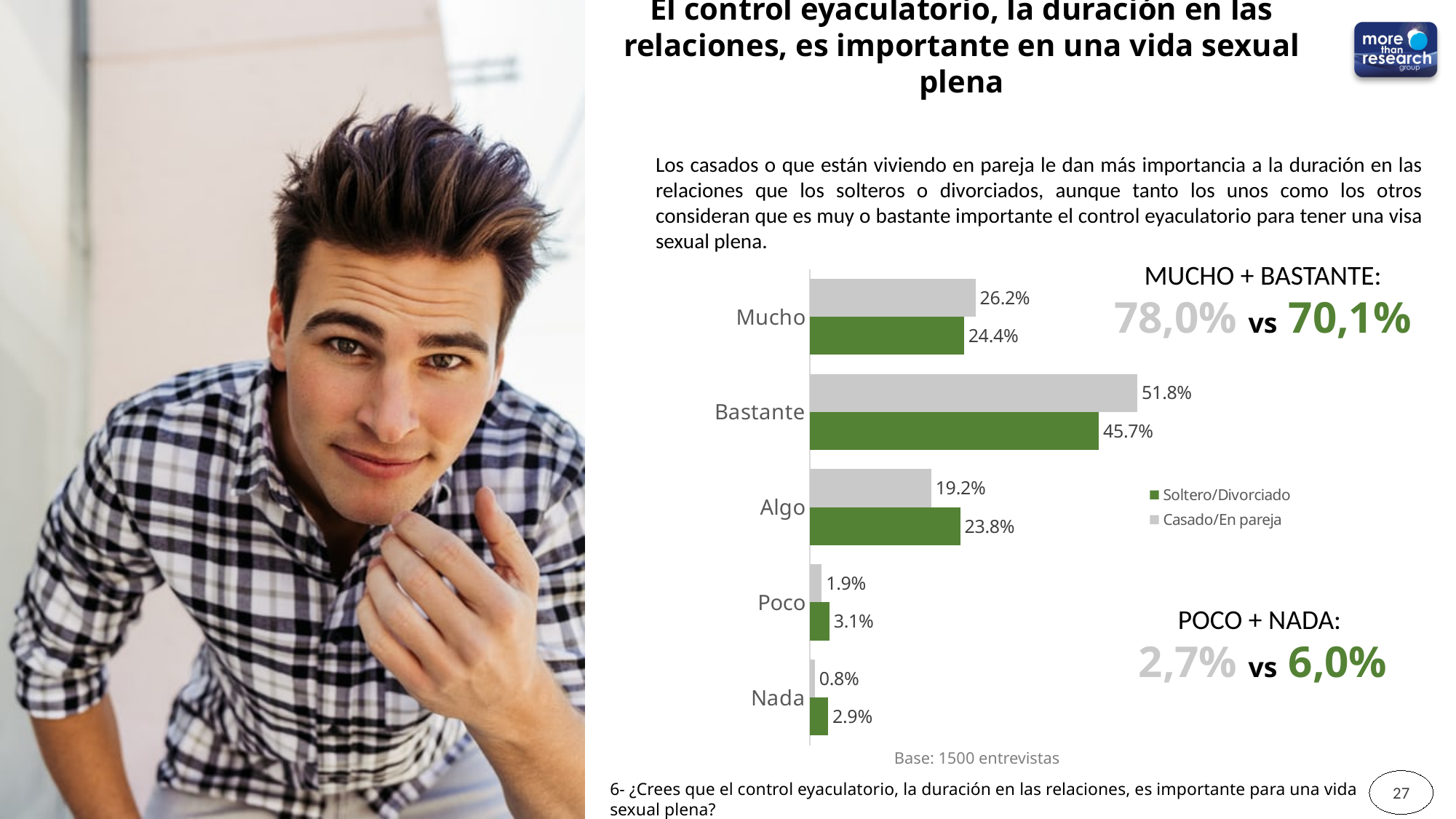
How many series does the legend list? 2 What is the value for Soltero/Divorciado in the Algo category? 23.8% How many categories are shown on the chart? 5 What kind of chart is shown on the slide? Bar chart Which category has the lowest value for Soltero/Divorciado? Nada Which category has the highest value for Casado/En pareja? Bastante Which colour represents the Soltero/Divorciado series? Green In the Mucho category, which series has the larger value, Soltero/Divorciado or Casado/En pareja? Casado/En pareja What is the value for Soltero/Divorciado in the Nada category? 2.9% What is the difference between the Casado/En pareja and Soltero/Divorciado values in the Bastante category? 6.1% What is the value for Casado/En pareja in the Bastante category? 51.8% In the Algo category, which series has the larger value, Soltero/Divorciado or Casado/En pareja? Soltero/Divorciado